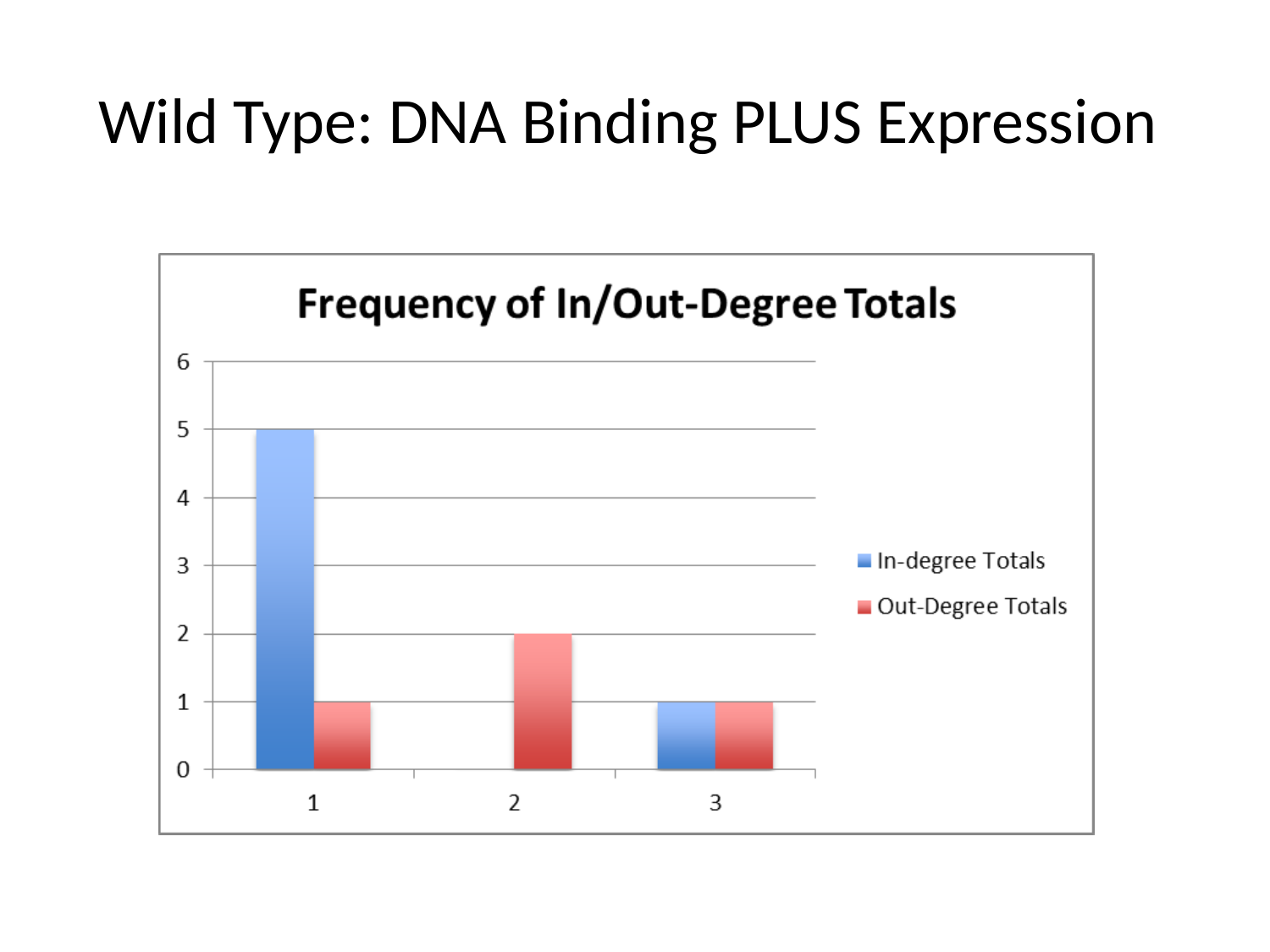
How many categories are shown on the x axis? 3 What is the Out-Degree Totals value for category 1? 1 How many series does the legend list? 2 What is the title of the chart? Frequency of In/Out-Degree Totals Which category has the highest Out-Degree Totals value? 2 What is the Out-Degree Totals value for category 2? 2 What kind of chart is shown on the slide? bar chart For category 1, which is larger: In-degree Totals or Out-Degree Totals? In-degree Totals What is the In-degree Totals value for category 1? 5 What is the difference between the In-degree Totals and Out-Degree Totals values for category 1? 4 Which category has the highest In-degree Totals value? 1 What is the In-degree Totals value for category 3? 1